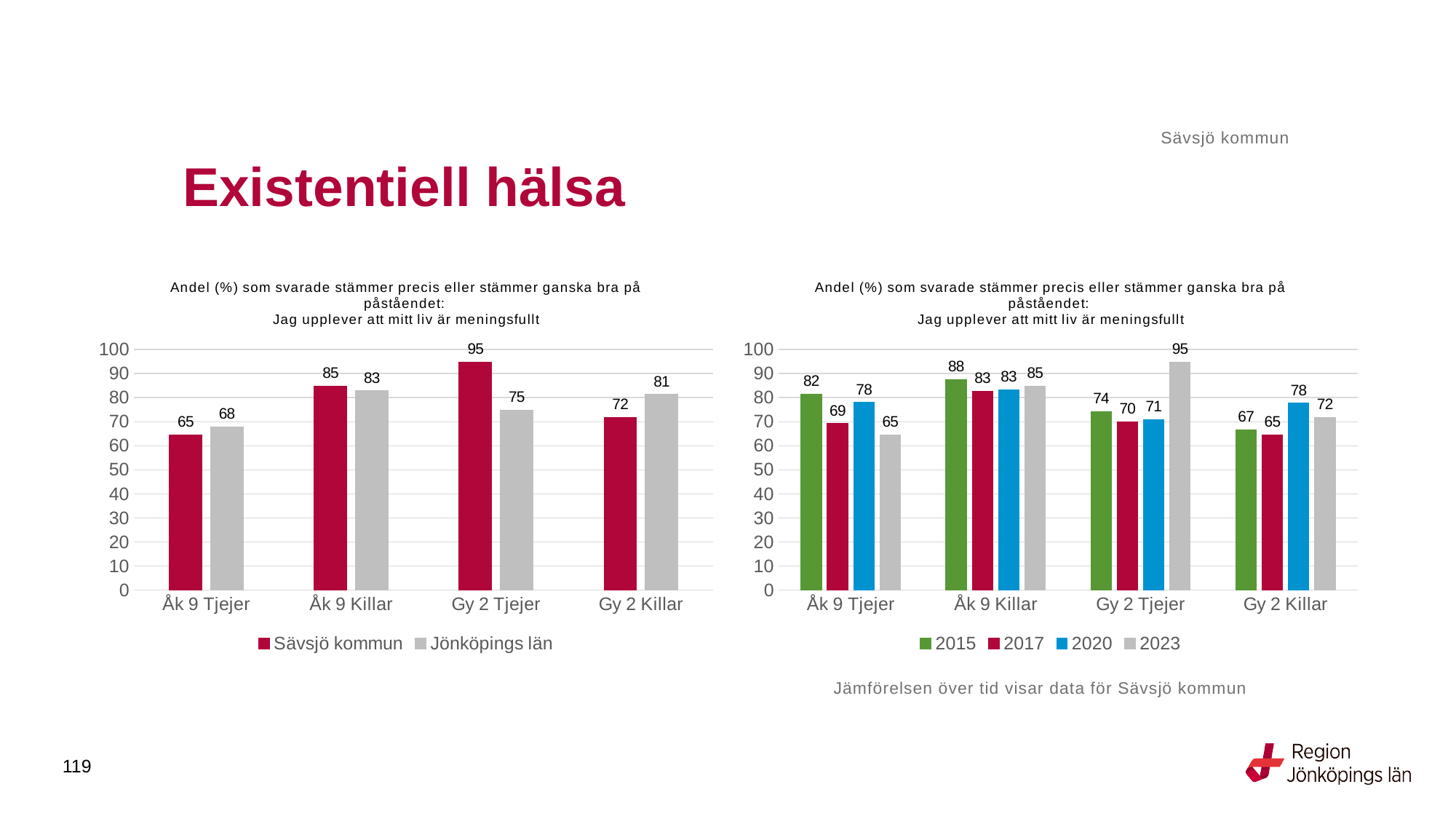
What type of chart is the right chart? Bar chart In the left chart, what is the value for Sävsjö kommun for Gy 2 Tjejer? 95 In the left chart, what is the value for Jönköpings län for Åk 9 Killar? 83 How many series does the legend of the left chart list? 2 How many series does the legend of the right chart list? 4 In the left chart, what is the difference between Sävsjö kommun and Jönköpings län for Gy 2 Tjejer? 20 In the left chart, which is larger for Gy 2 Killar: Sävsjö kommun or Jönköpings län? Jönköpings län In the right chart, which year has the highest value for Gy 2 Tjejer? 2023 In the right chart, what is the difference between 2015 and 2023 for Åk 9 Tjejer? 17 In the right chart, what is the value for 2015 for Åk 9 Killar? 88 In the left chart, which category has the lowest value for Sävsjö kommun? Åk 9 Tjejer In the right chart, what is the value for 2020 for Gy 2 Killar? 78